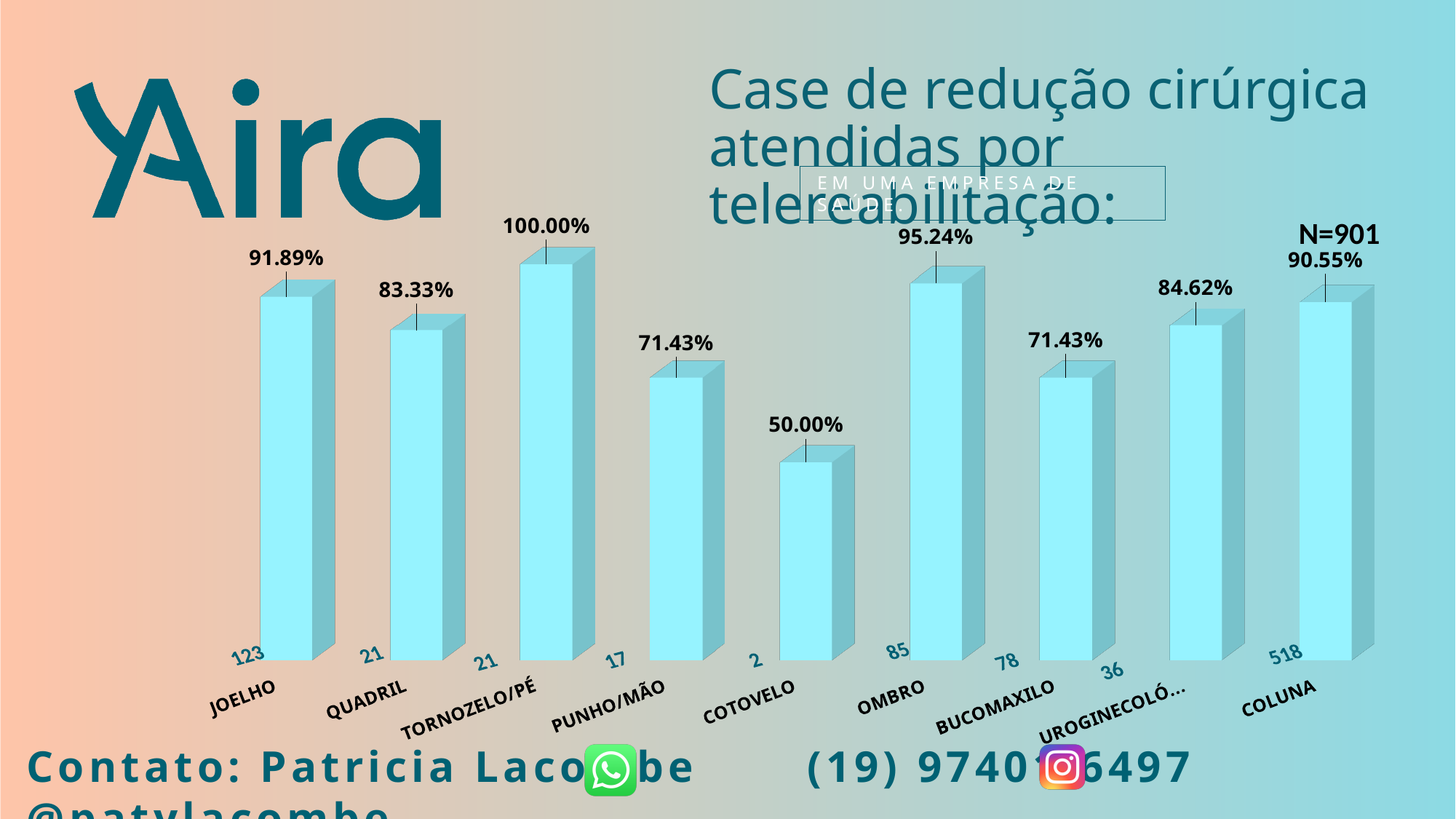
What is the difference between the values for JOELHO and QUADRIL? 8.56% What is the value for COTOVELO? 50.00% Which category has the highest value? TORNOZELO/PÉ What is the value for COLUNA? 90.55% How many categories are shown in the chart? 9 What is the value for BUCOMAXILO? 71.43% Which category has the lowest value? COTOVELO What total N is stated on the chart? N=901 What is the value for TORNOZELO/PÉ? 100.00% What kind of chart is shown on the slide? Bar chart Which is larger, the value for OMBRO or the value for COLUNA? OMBRO What is the value for OMBRO? 95.24%